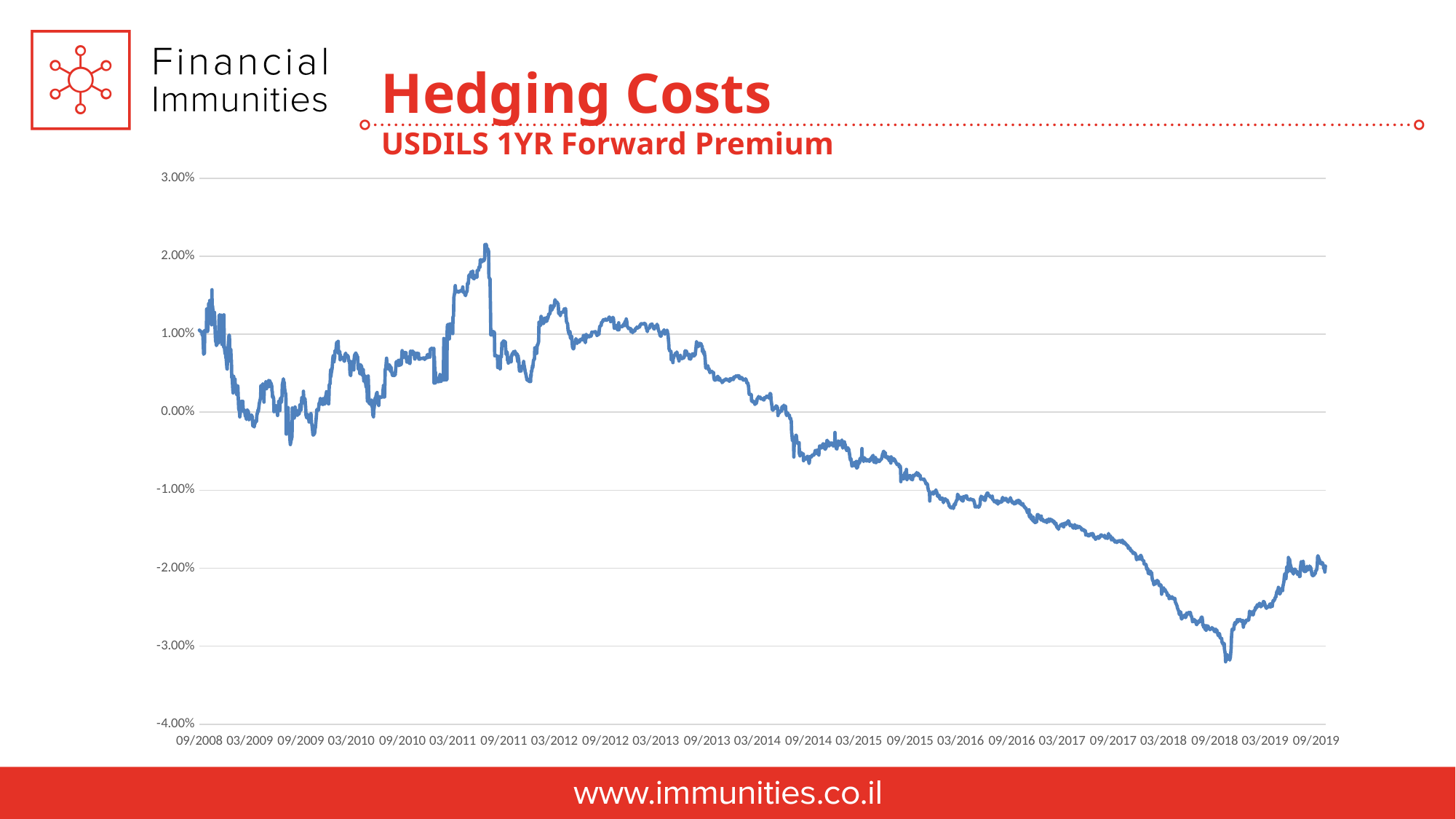
What is the title of the chart? USDILS 1YR Forward Premium Is the value at 03/2017 greater or less than -2.00%? greater Is the value at 03/2018 greater or less than -1.00%? less Is the lowest point of the line greater or less than -3.00%? less What kind of chart is shown on the slide? line chart Overall, does the line rise or fall from 09/2008 to 09/2019? fall How many date labels are shown on the x axis? 23